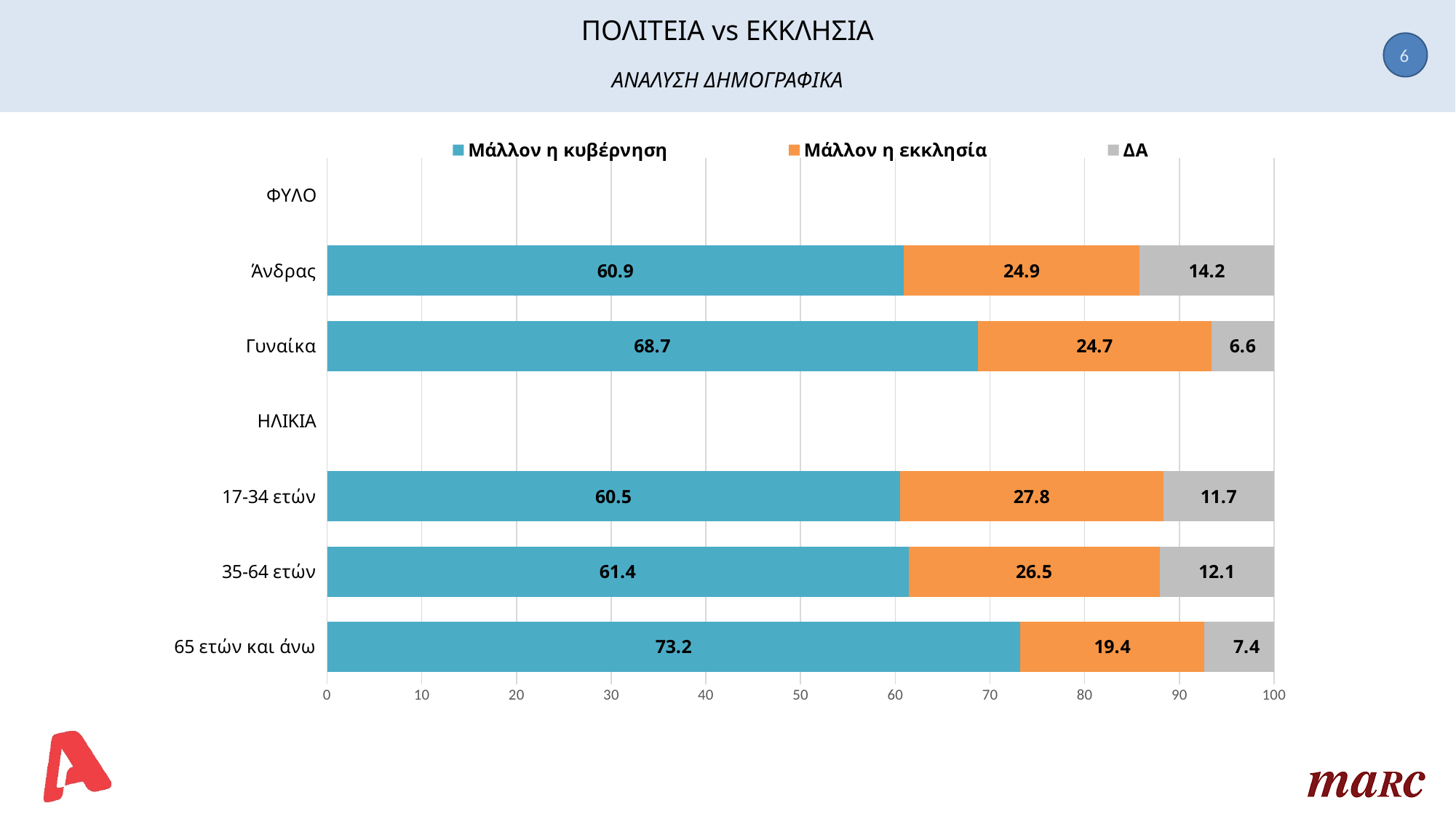
Which is larger: the "ΔΑ" value for Άνδρας or for 35-64 ετών? Άνδρας What is the value for "ΔΑ" for Γυναίκα? 6.6 What is the total of the stacked bar for 65 ετών και άνω? 100 What kind of chart is shown on the slide? stacked bar chart Is the "Μάλλον η κυβέρνηση" value for 35-64 ετών greater or less than 70? less What is the value for "Μάλλον η εκκλησία" for 17-34 ετών? 27.8 What is the difference between the "Μάλλον η κυβέρνηση" values for Γυναίκα and Άνδρας? 7.8 What is the value for "Μάλλον η κυβέρνηση" for Άνδρας? 60.9 Which category has the highest value for "Μάλλον η κυβέρνηση"? 65 ετών και άνω How many series does the legend list? 3 Which category has the lowest value for "Μάλλον η εκκλησία"? 65 ετών και άνω What colour represents the "Μάλλον η εκκλησία" series? orange